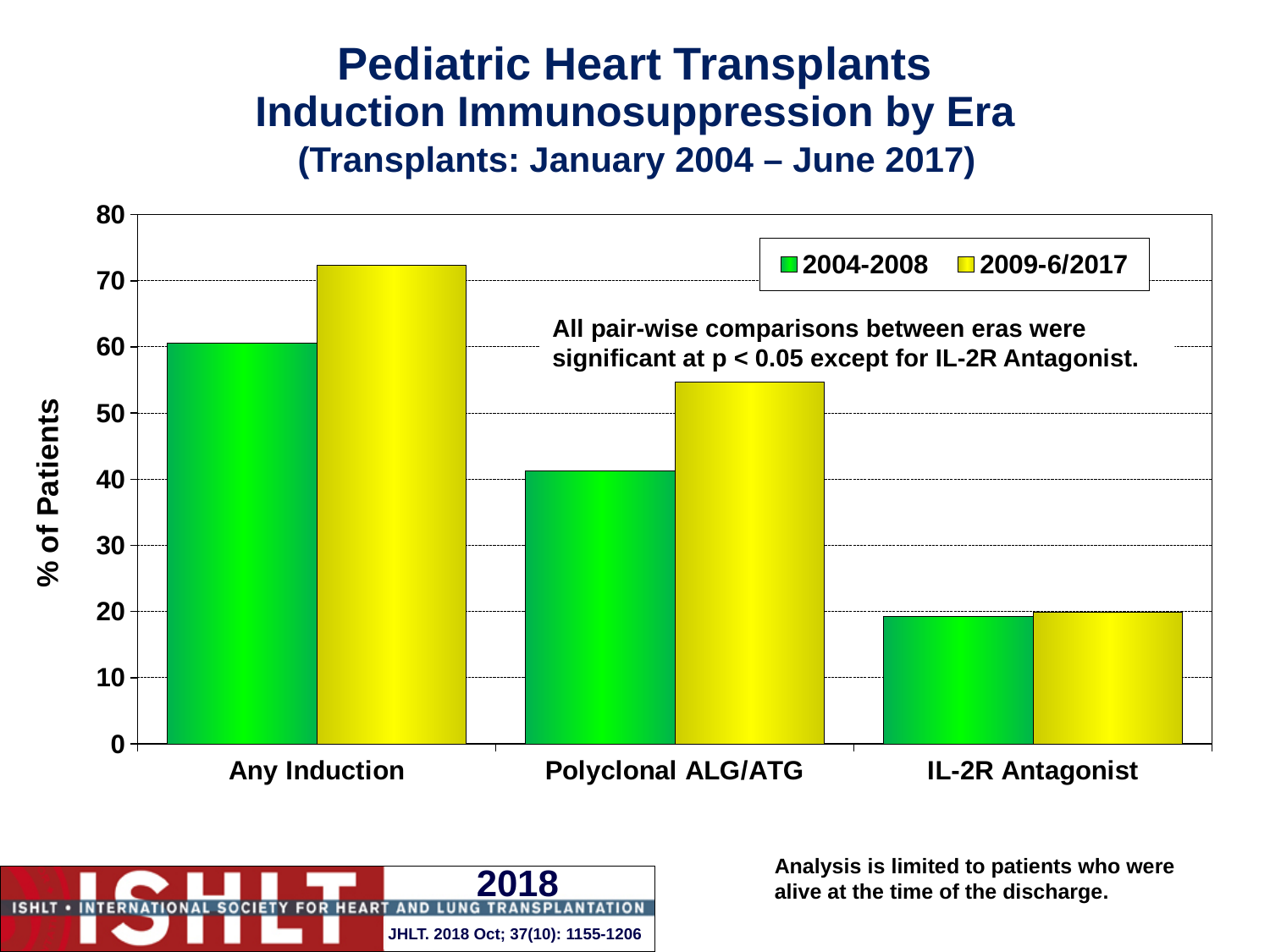
Is the value for IL-2R Antagonist in 2004-2008 greater or less than 30? less How many series does the legend list? 2 What is the label of the y axis? % of Patients Is the value for Polyclonal ALG/ATG in 2004-2008 greater or less than 50? less For Polyclonal ALG/ATG, which era has the larger value, 2004-2008 or 2009-6/2017? 2009-6/2017 Which category has the lowest value for the 2004-2008 series? IL-2R Antagonist For Any Induction, which era has the larger value, 2004-2008 or 2009-6/2017? 2009-6/2017 Is the value for Any Induction in 2009-6/2017 greater or less than 70? greater What kind of chart is shown on the slide? bar chart How many categories are shown on the x axis? 3 Which category has the highest value for the 2009-6/2017 series? Any Induction